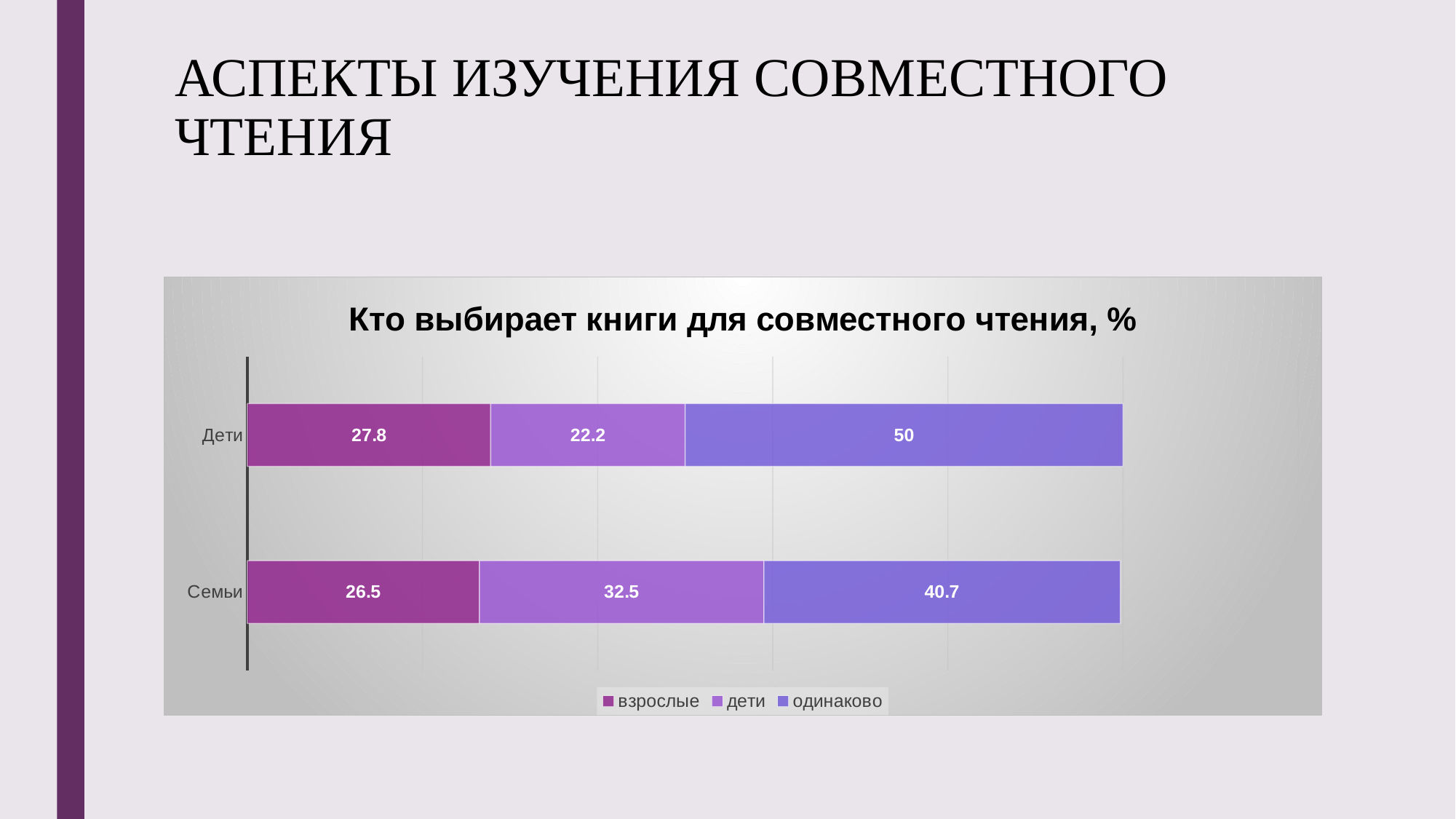
Which series has the highest value for 'Семьи'? одинаково How many series does the legend list? 3 What is the total of the stacked bar for 'Семьи'? 99.7 What is the difference between the 'одинаково' values for 'Дети' and 'Семьи'? 9.3 What is the value of the 'дети' series for 'Дети'? 22.2 What type of chart is shown on the slide? stacked bar chart What is the value of the 'дети' series for 'Семьи'? 32.5 What is the value of the 'взрослые' series for 'Семьи'? 26.5 What is the value of the 'одинаково' series for 'Дети'? 50 What is the title of the chart? Кто выбирает книги для совместного чтения, % Which series has the lowest value for 'Дети'? дети How many categories are shown on the chart? 2